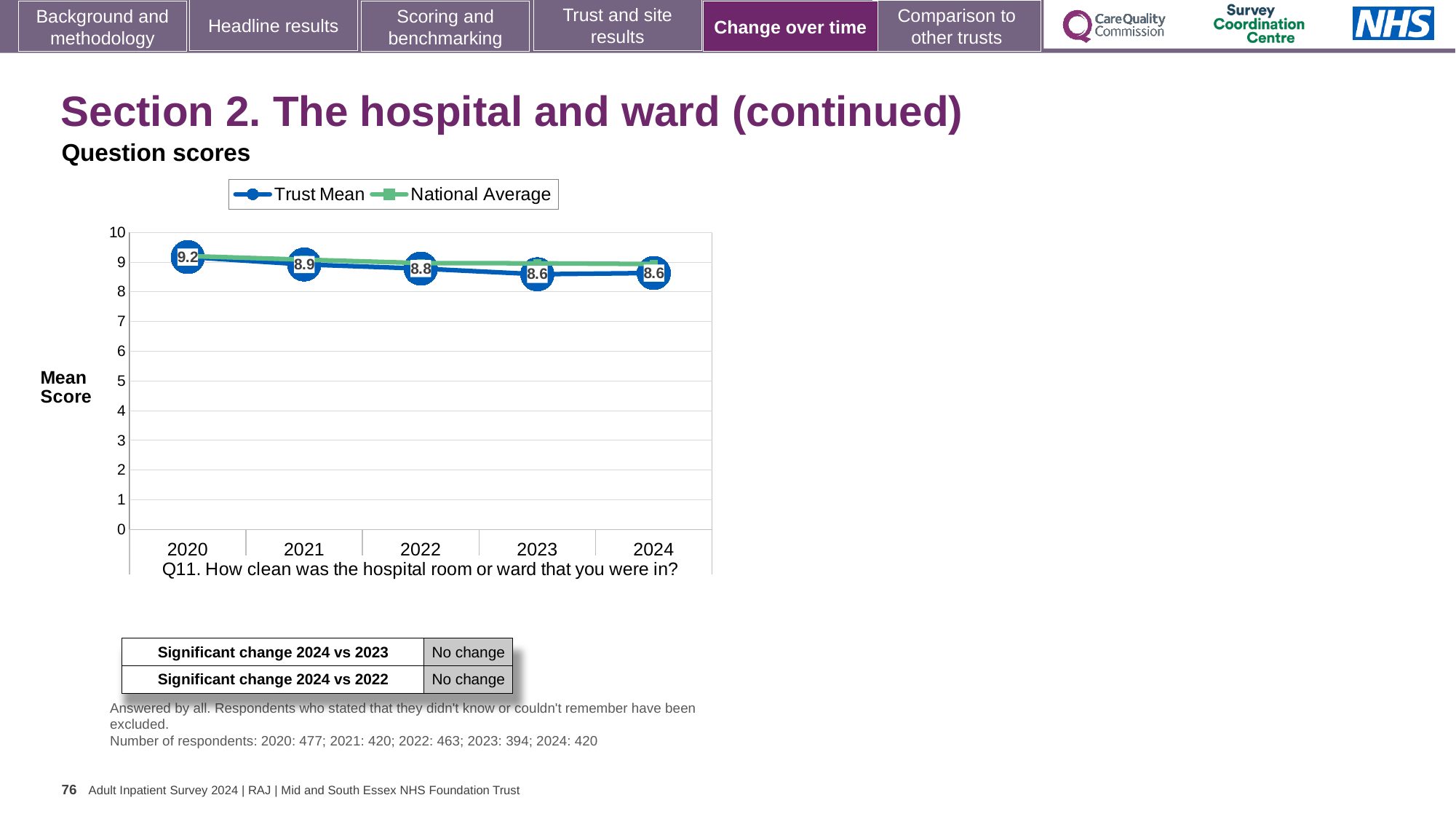
What kind of chart is shown on the slide? Line chart How many years are plotted on the x axis? 5 What is the Trust Mean score for 2024? 8.6 In which year is the Trust Mean highest? 2020 Which year has the larger Trust Mean, 2021 or 2023? 2021 What is the difference between the Trust Mean in 2020 and in 2024? 0.6 What is the Trust Mean score for 2020? 9.2 What is the Trust Mean score for 2022? 8.8 Does the Trust Mean generally rise or fall from 2020 to 2024? Fall Is the National Average value for 2024 greater or less than 8? greater How many series does the legend list? 2 What is the lowest Trust Mean score shown on the chart? 8.6